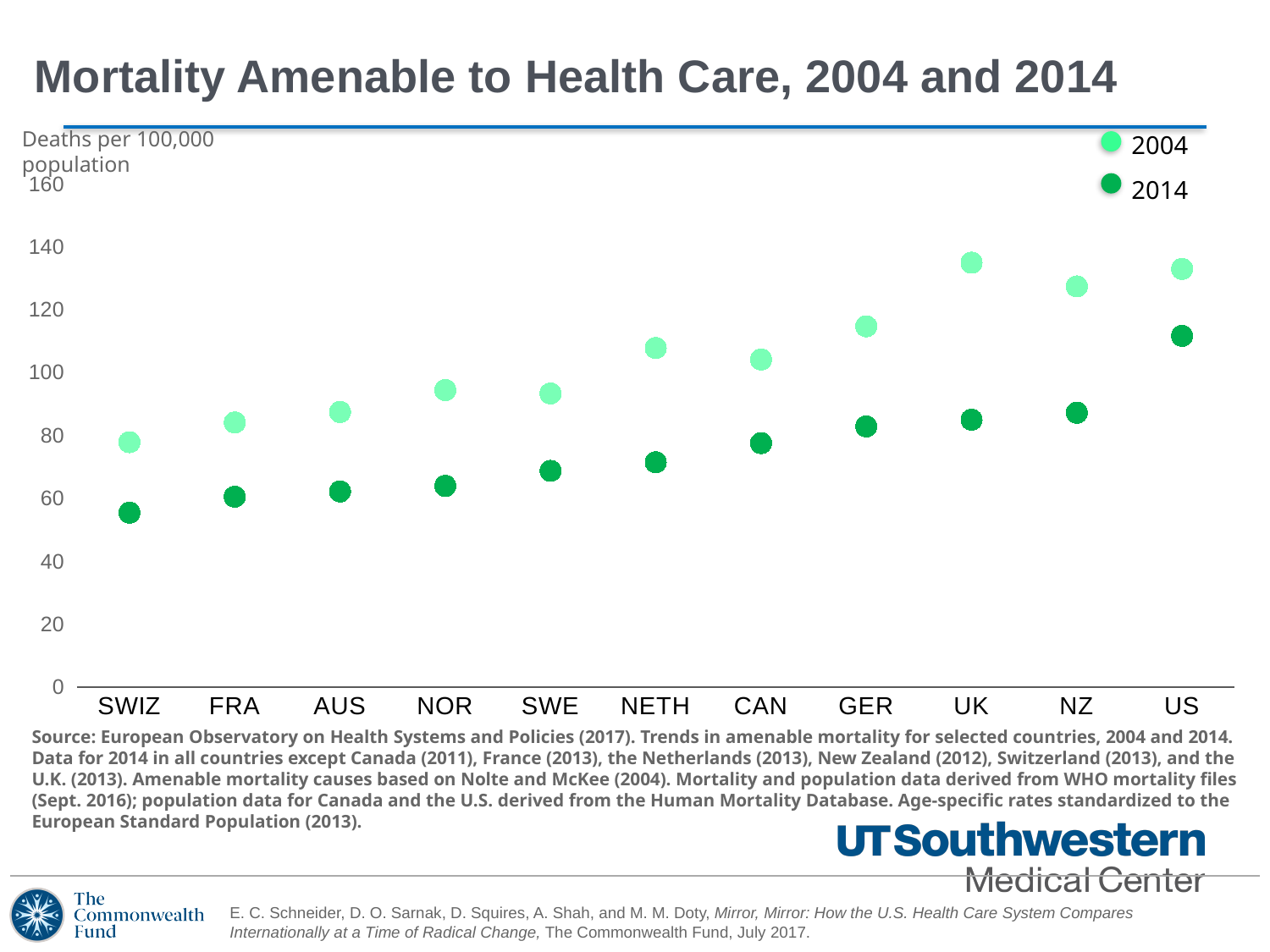
How many series does the legend list? 2 How many countries are shown on the x axis of the chart? 11 What kind of chart is shown on the slide? Dot (scatter) chart Which country has the lowest 2004 value? SWIZ For Germany (GER), which is larger: the 2004 value or the 2014 value? 2004 Is the 2014 value for NETH greater or less than 80? less Is the 2014 value for the US greater or less than 100? greater Is the 2014 value for SWIZ greater or less than 60? less Which country has the highest 2014 value? US Do the 2014 values generally rise or fall moving from SWIZ on the left to US on the right? rise Which country has the lowest 2014 value? SWIZ